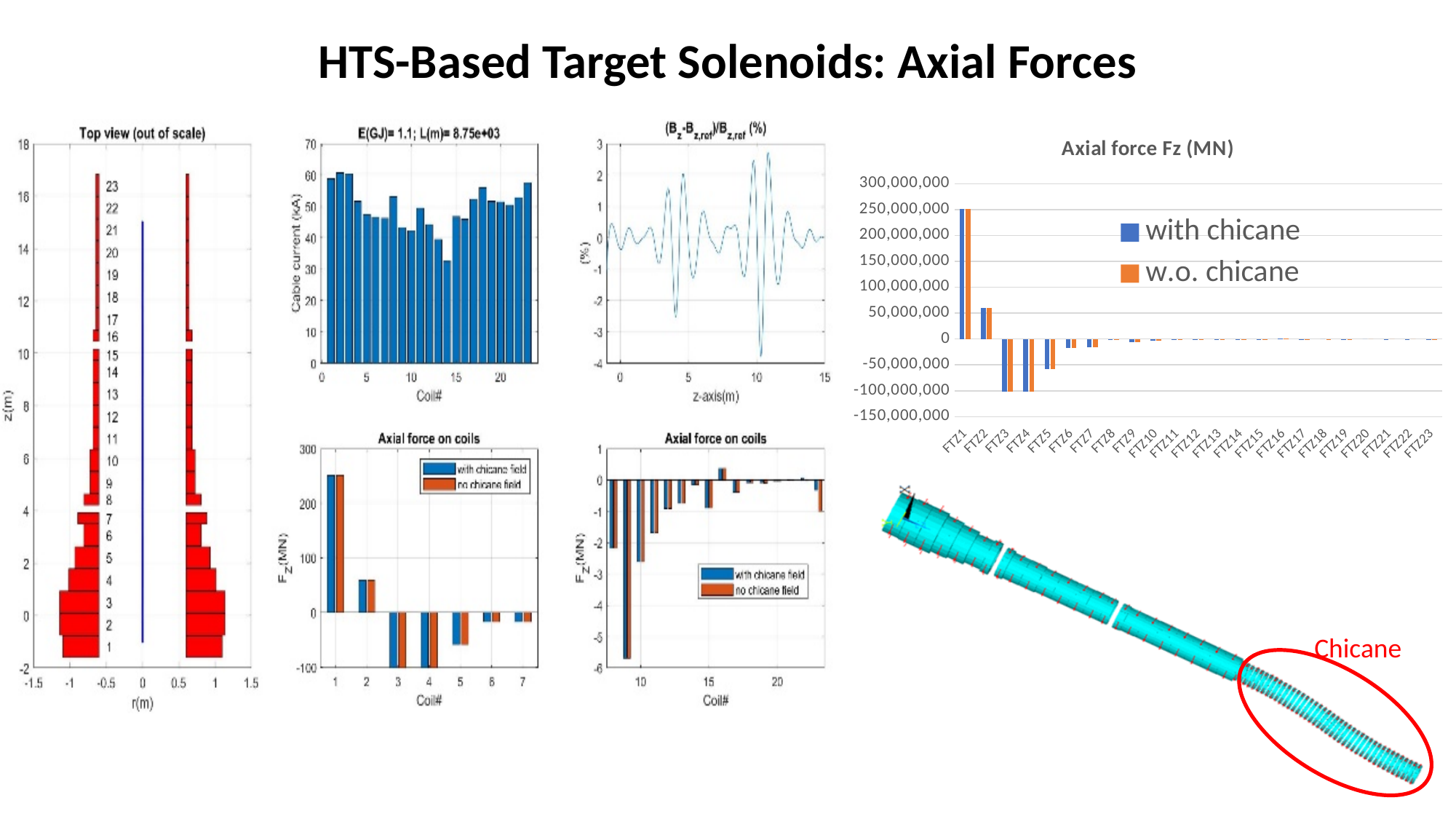
In the 'Axial force Fz (MN)' chart, which is larger, the 'with chicane' value for FTZ1 or for FTZ2? FTZ1 In the 'Axial force Fz (MN)' chart, is the 'w.o. chicane' value for FTZ3 greater or less than -50,000,000? less In the 'Cable current (kA)' chart (top middle), is the value for coil 1 greater or less than 50? greater In the 'Axial force Fz (MN)' chart, how many series does the legend list? 2 In the 'Axial force on coils' chart for coils 1 to 7 (bottom middle-left), is the 'with chicane field' value for coil 1 greater or less than 200? greater How many categories are shown on the x axis of the 'Axial force Fz (MN)' chart? 23 In the 'Axial force Fz (MN)' chart, what are the two legend entries? with chicane, w.o. chicane In the 'Axial force Fz (MN)' chart, which category has the highest value? FTZ1 What kind of chart is the 'Axial force Fz (MN)' chart? bar chart